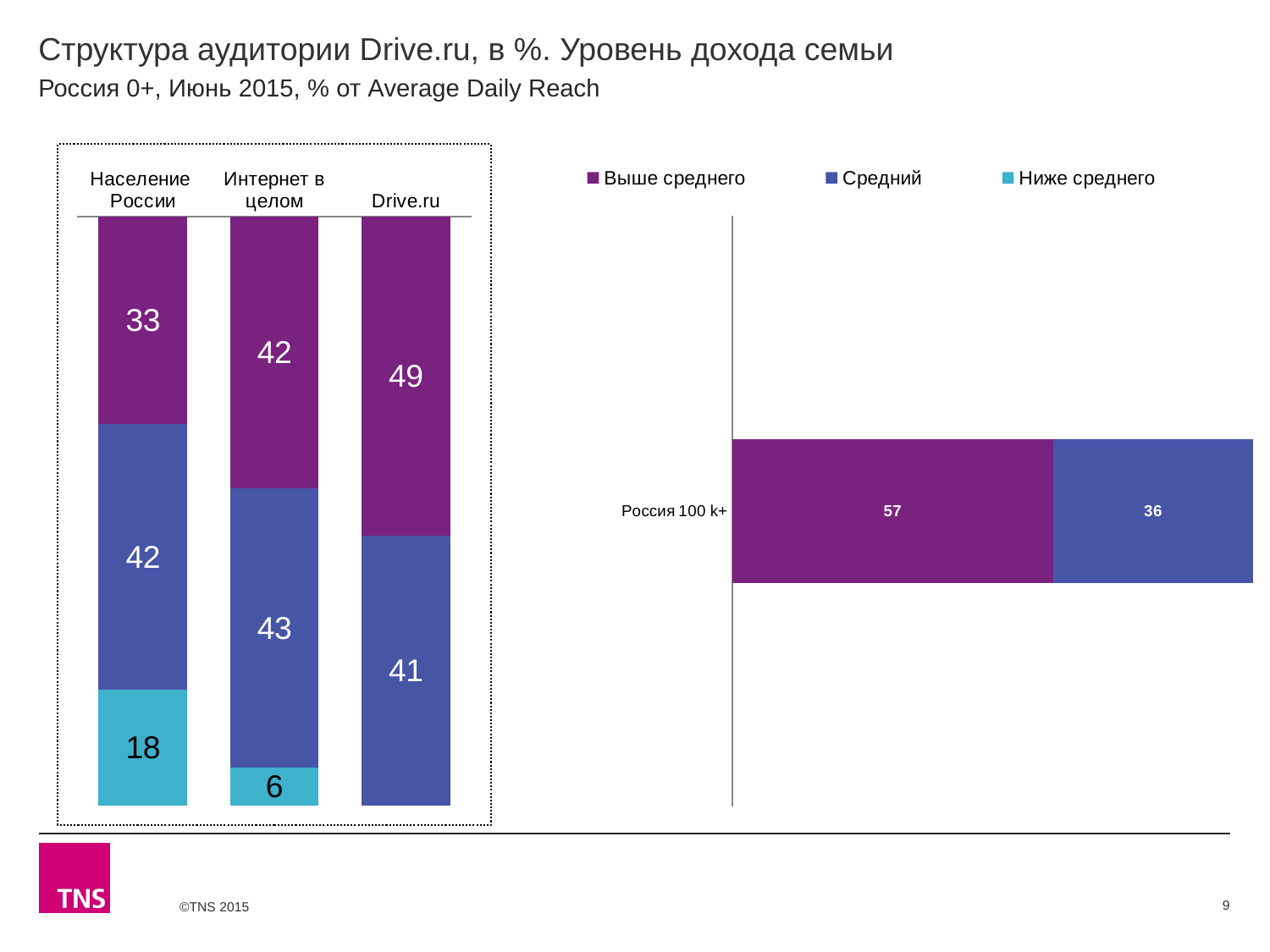
In the left chart, what is the value of the 'Ниже среднего' segment for Население России? 18 How many series does the legend list? 3 In the left chart, which category has the highest 'Выше среднего' value? Drive.ru How many categories are shown on the x axis of the left chart? 3 In the left chart, is the 'Средний' value larger for Население России or for Drive.ru? Население России In the left chart, what is the value of the 'Выше среднего' segment for Drive.ru? 49 What type of chart is the right chart? Stacked bar chart In the right chart, what is the difference between the 'Выше среднего' and 'Средний' values for Россия 100 k+? 21 In the right chart, what is the value of the 'Выше среднего' segment for Россия 100 k+? 57 In the left chart, what is the value of the 'Средний' segment for Интернет в целом? 43 In the left chart, which category has the lowest 'Ниже среднего' value among those with a labelled segment? Интернет в целом In the left chart, what is the difference between the 'Выше среднего' values for Drive.ru and Население России? 16